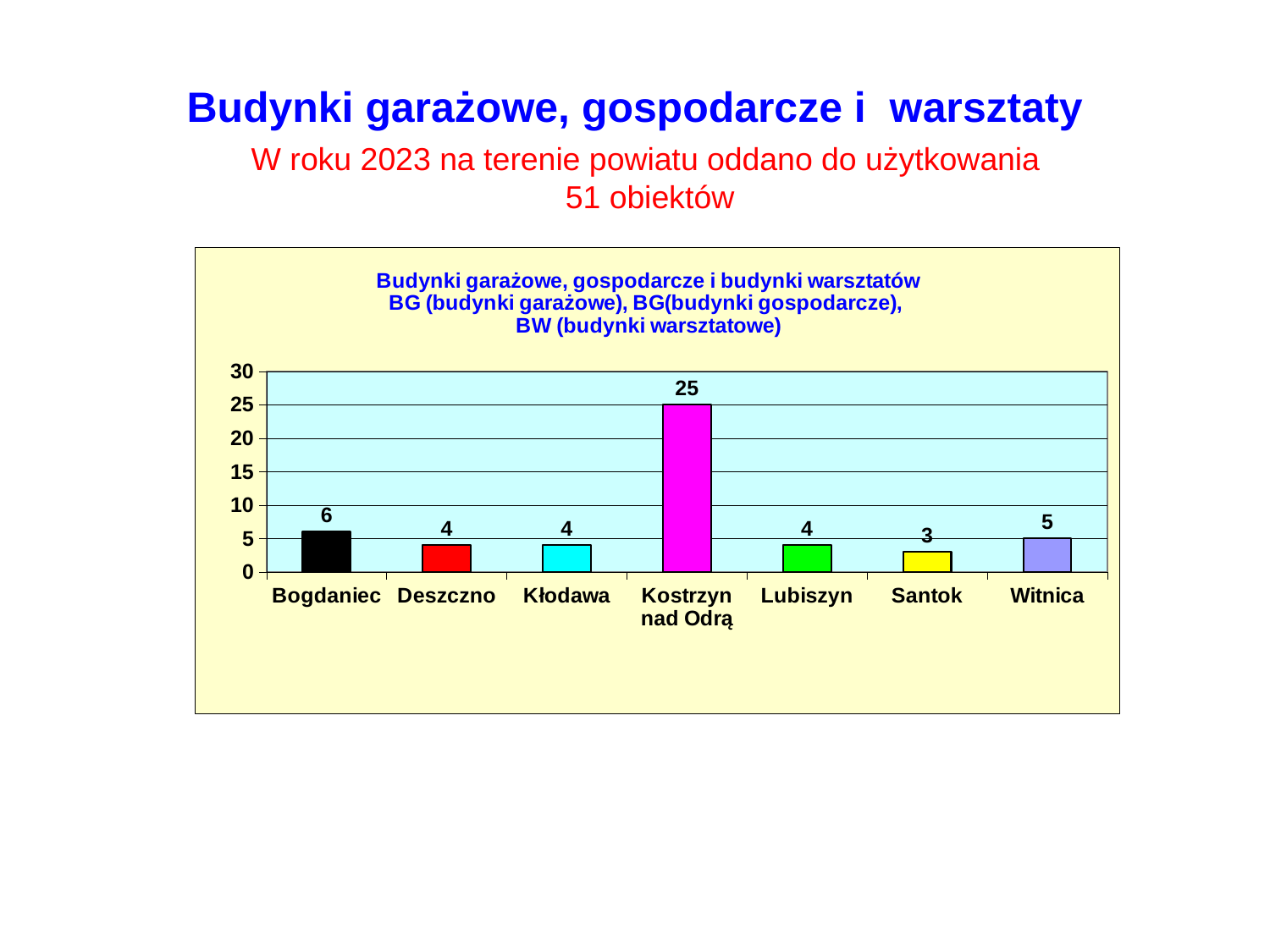
Which category has the lowest value? Santok What is the value for Witnica? 5 What is the value for Kostrzyn nad Odrą? 25 How many categories are shown on the x axis? 7 What is the difference between the values for Kostrzyn nad Odrą and Bogdaniec? 19 Which is larger, the value for Witnica or the value for Santok? Witnica What colour is the bar for Kostrzyn nad Odrą? magenta Which category has the highest value? Kostrzyn nad Odrą Is the value for Kostrzyn nad Odrą greater or less than 20? greater What is the value for Santok? 3 What is the value for Bogdaniec? 6 What kind of chart is shown on the slide? bar chart